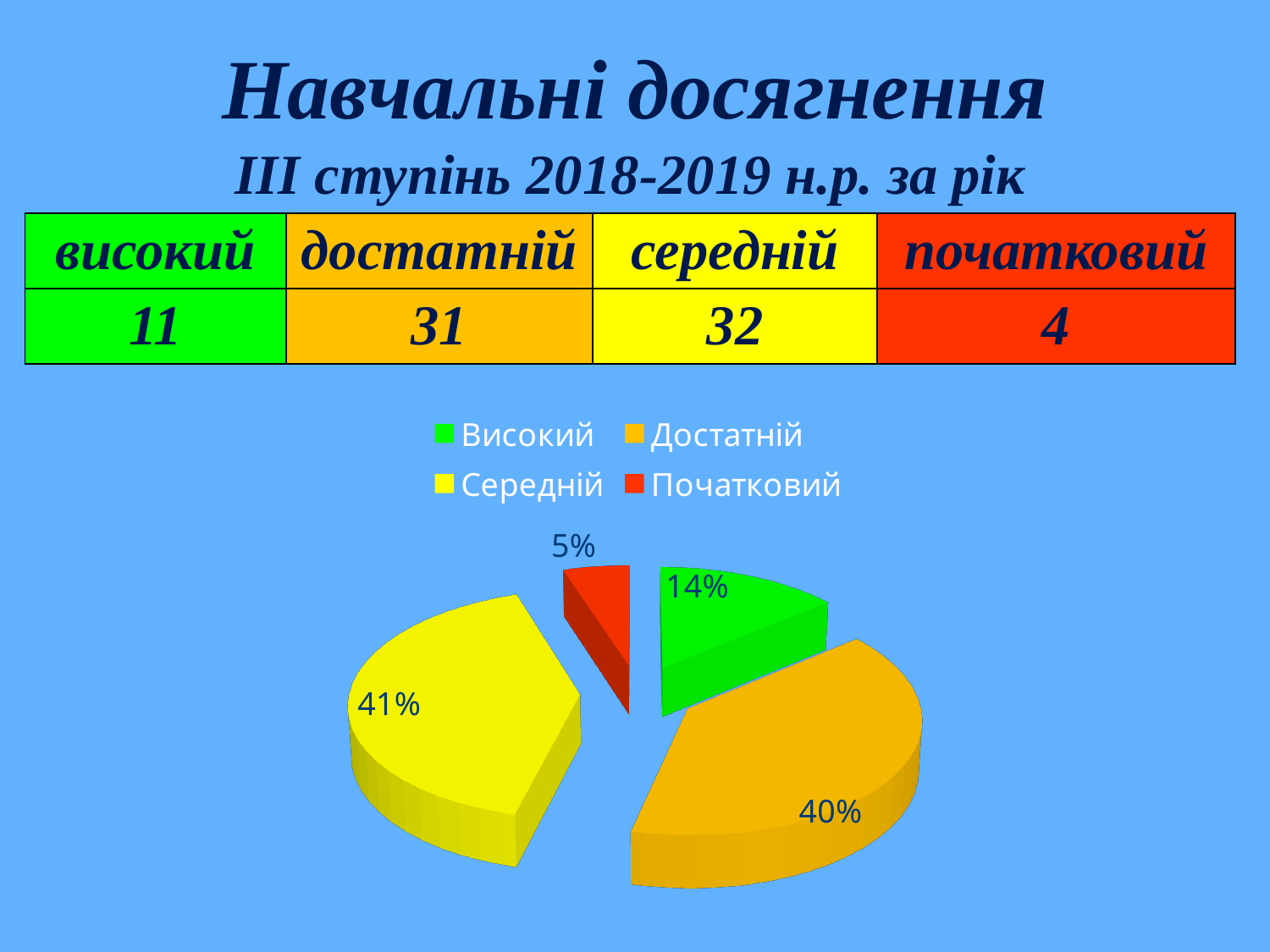
Which slice of the pie chart is the smallest? Початковий What is the difference in percentage points between the Достатній slice and the Високий slice? 26% Which is larger in the pie chart, the Високий slice or the Початковий slice? Високий What colour is the Середній slice in the pie chart? yellow Which slice of the pie chart is the largest? Середній What share of the pie does the Достатній slice represent? 40% What share of the pie does the Середній slice represent? 41% What kind of chart is shown on the slide? pie chart What share of the pie does the Високий slice represent? 14% How many entries does the legend of the pie chart list? 4 How many slices does the pie chart have? 4